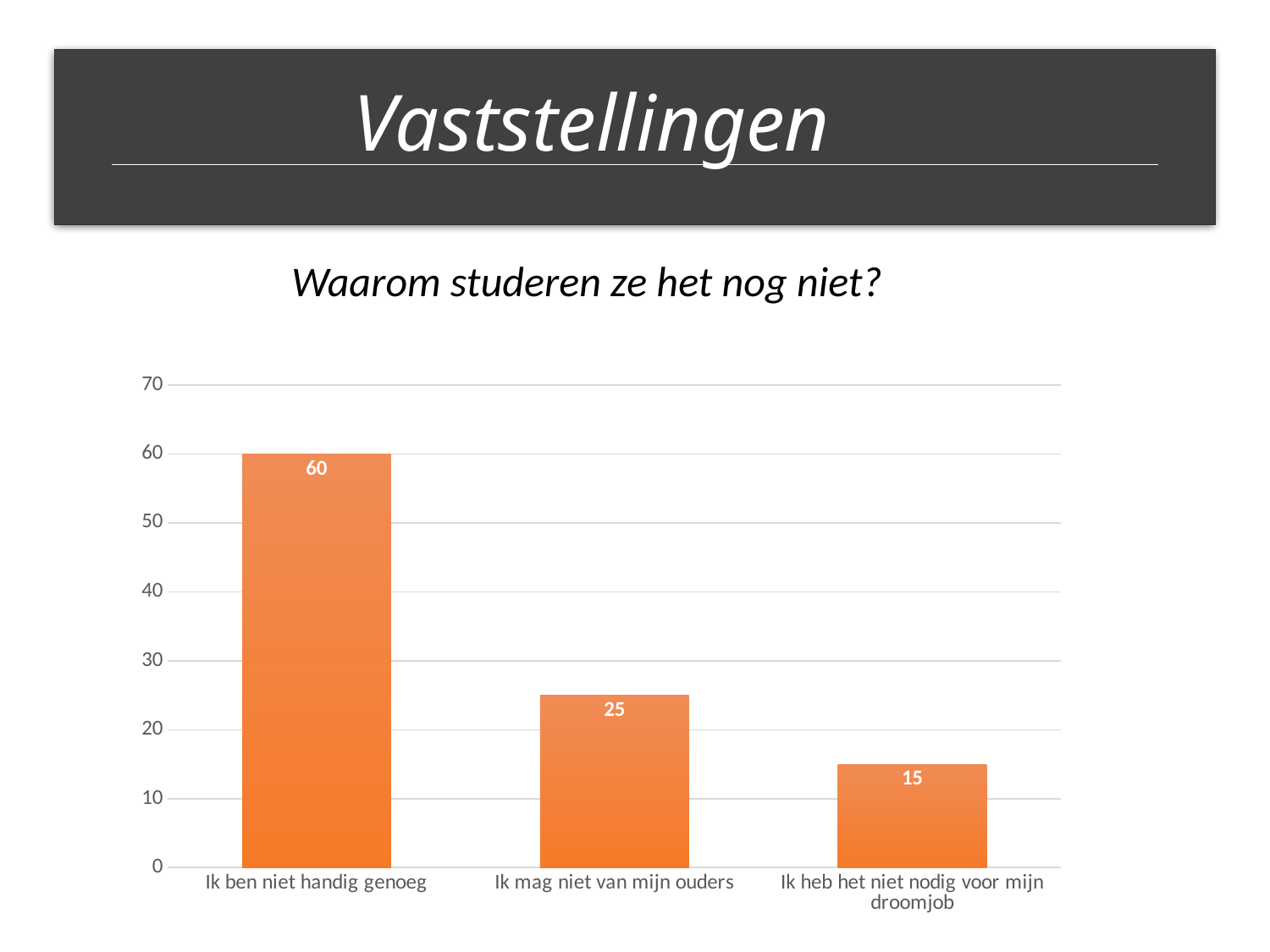
What kind of chart is shown on the slide? bar chart What is the value for "Ik ben niet handig genoeg"? 60 What is the difference between the values for "Ik mag niet van mijn ouders" and "Ik heb het niet nodig voor mijn droomjob"? 10 Which is larger: the value for "Ik mag niet van mijn ouders" or for "Ik heb het niet nodig voor mijn droomjob"? Ik mag niet van mijn ouders Which category has the highest value? Ik ben niet handig genoeg How many categories are shown on the x axis? 3 Is the value for "Ik ben niet handig genoeg" greater or less than 50? greater What is the value for "Ik heb het niet nodig voor mijn droomjob"? 15 Do the values rise or fall from left to right along the x axis? fall What is the value for "Ik mag niet van mijn ouders"? 25 Which category has the lowest value? Ik heb het niet nodig voor mijn droomjob What is the difference between the values for "Ik ben niet handig genoeg" and "Ik mag niet van mijn ouders"? 35